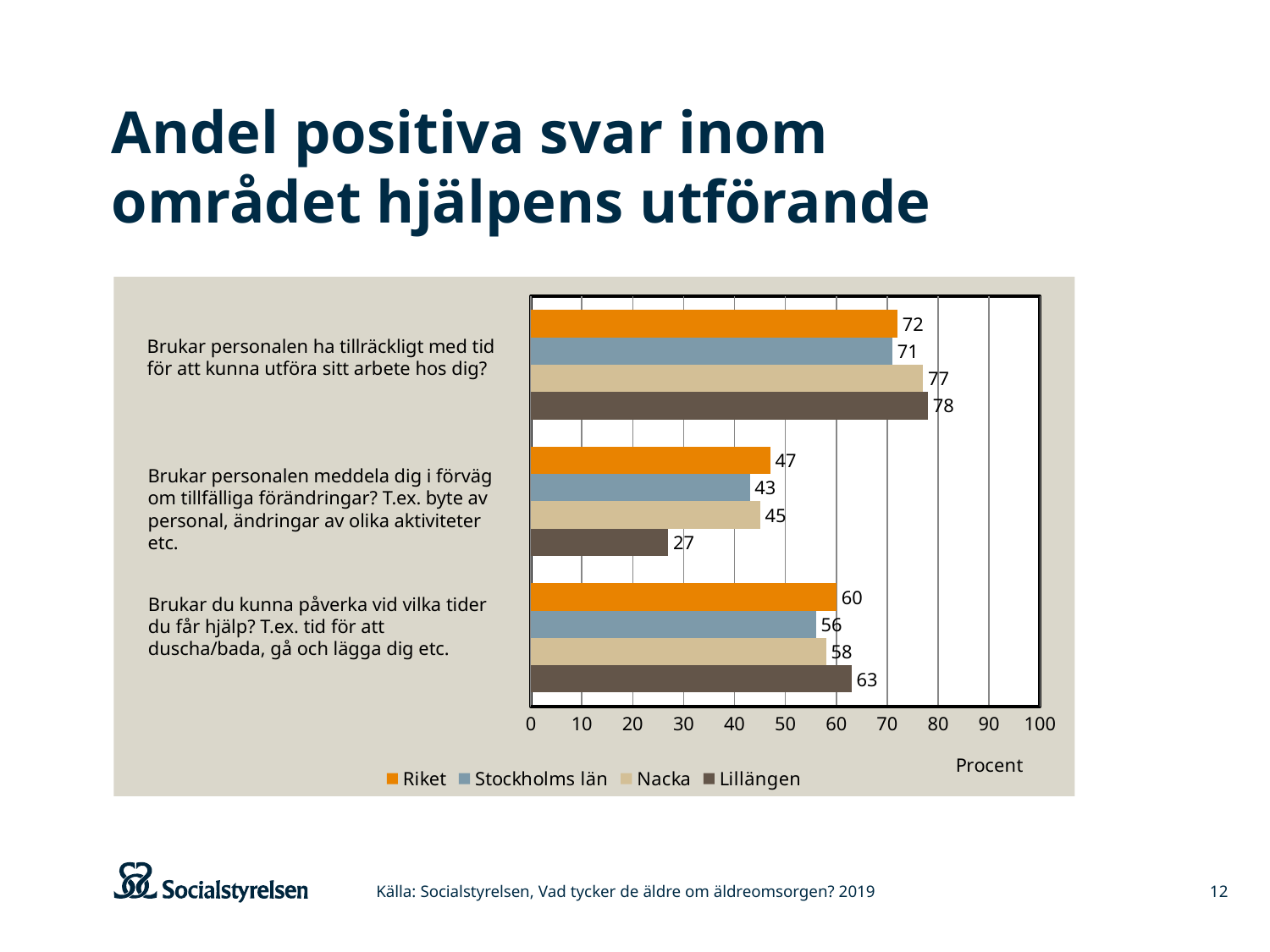
What is the difference between Riket and Lillängen on the question "Brukar personalen meddela dig i förväg om tillfälliga förändringar?"? 20 What is the value for Riket on the question "Brukar du kunna påverka vid vilka tider du får hjälp?"? 60 How many series does the legend list? 4 What kind of chart is shown on the slide? Bar chart What is the value for Lillängen on the question "Brukar personalen ha tillräckligt med tid för att kunna utföra sitt arbete hos dig?"? 78 What is the value for Stockholms län on the question "Brukar personalen meddela dig i förväg om tillfälliga förändringar?"? 43 Which series has the highest value on the question "Brukar du kunna påverka vid vilka tider du får hjälp?"? Lillängen What is the label of the x axis? Procent What is the difference between Nacka and Riket on the question "Brukar personalen ha tillräckligt med tid för att kunna utföra sitt arbete hos dig?"? 5 On the question "Brukar du kunna påverka vid vilka tider du får hjälp?", which is larger: Nacka or Stockholms län? Nacka How many question categories are shown on the chart? 3 Which series has the lowest value on the question "Brukar personalen meddela dig i förväg om tillfälliga förändringar?"? Lillängen